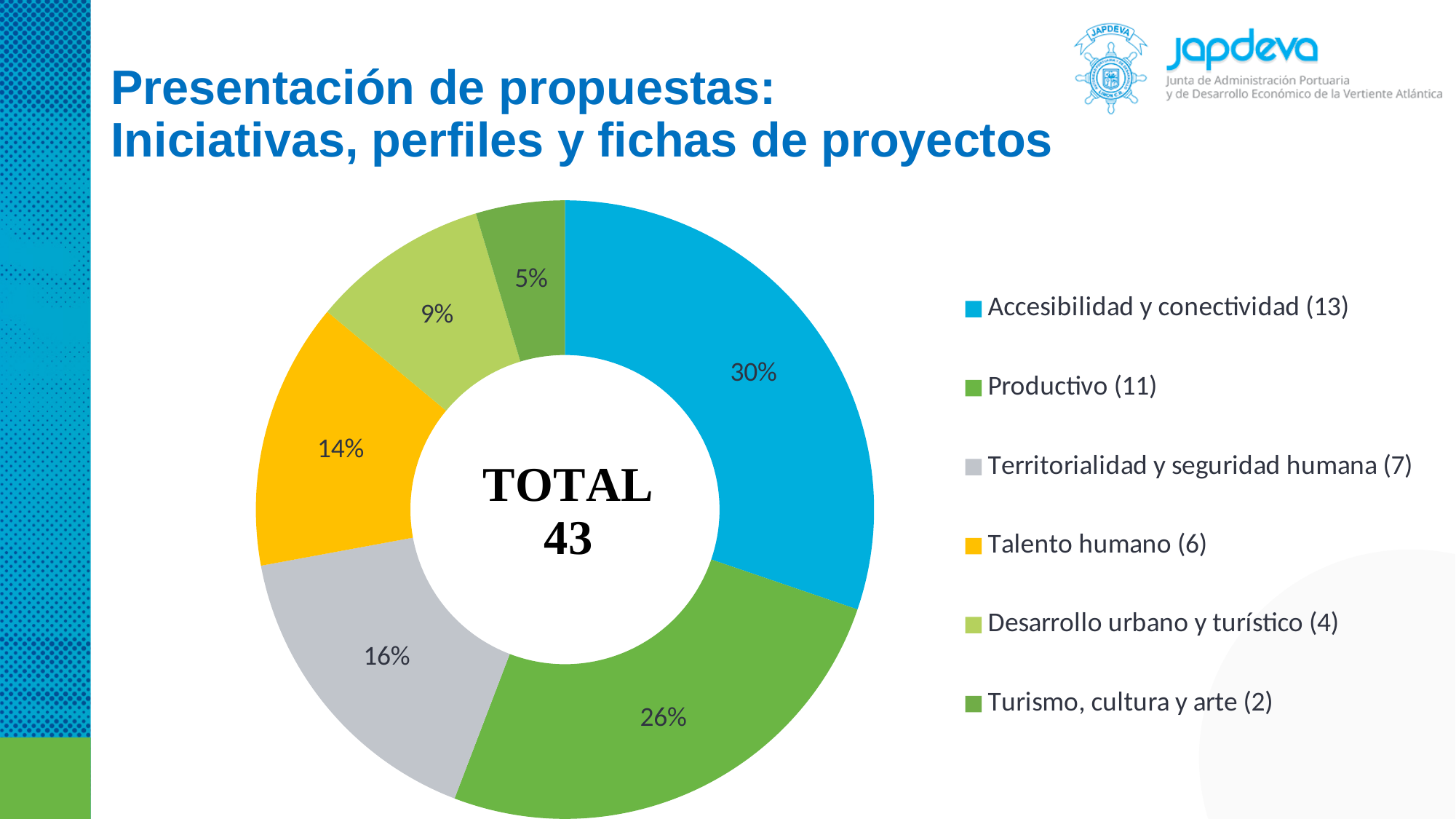
Which slice is larger: Productivo or Talento humano? Productivo What share of the pie does Talento humano represent? 14% What is the difference in percentage points between the Accesibilidad y conectividad slice and the Desarrollo urbano y turístico slice? 21% Which category has the largest slice of the pie? Accesibilidad y conectividad What total is printed in the centre of the doughnut chart? 43 What share of the pie does Accesibilidad y conectividad represent? 30% How many categories does the pie chart show? 6 Which category has the smallest slice of the pie? Turismo, cultura y arte What kind of chart is shown on the slide? Pie chart (doughnut) What share of the pie does Turismo, cultura y arte represent? 5%